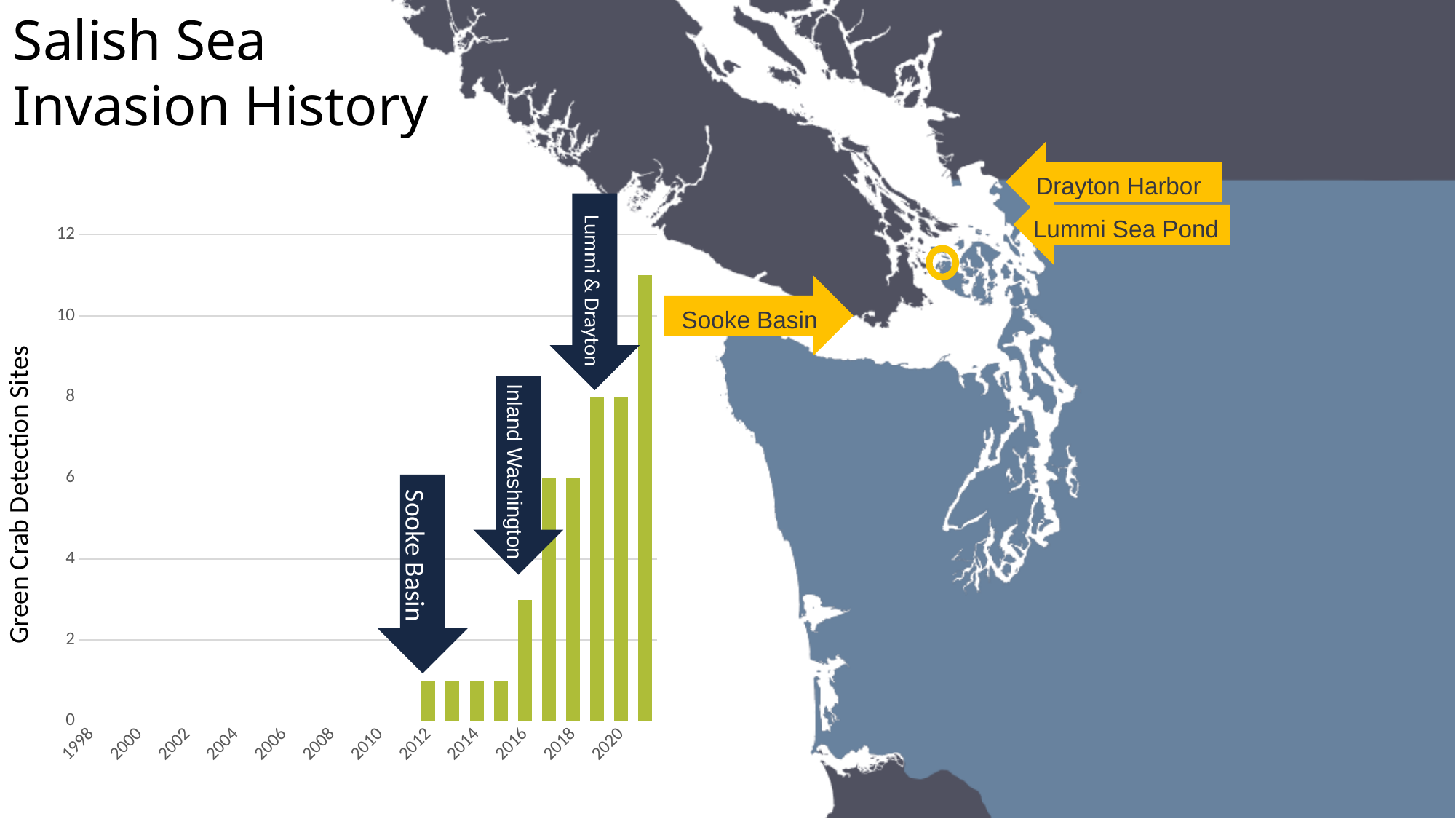
Do the values generally rise or fall from left to right along the x axis? rise Which is larger, the value for 2018 or the value for 2020? 2020 What is the first year label shown on the x axis? 1998 How many bars are plotted in the chart? 10 What is the difference between the values for 2020 and 2018? 2 What is the value for 2018 in the chart? 6 What is the value for 2020 in the chart? 8 Is the value for 2012 greater or less than 2? less Is the value for 2016 greater or less than 2? greater Is the value of the rightmost bar greater or less than 10? greater What type of chart is shown on the slide? bar chart What is the title of the vertical axis of the chart? Green Crab Detection Sites